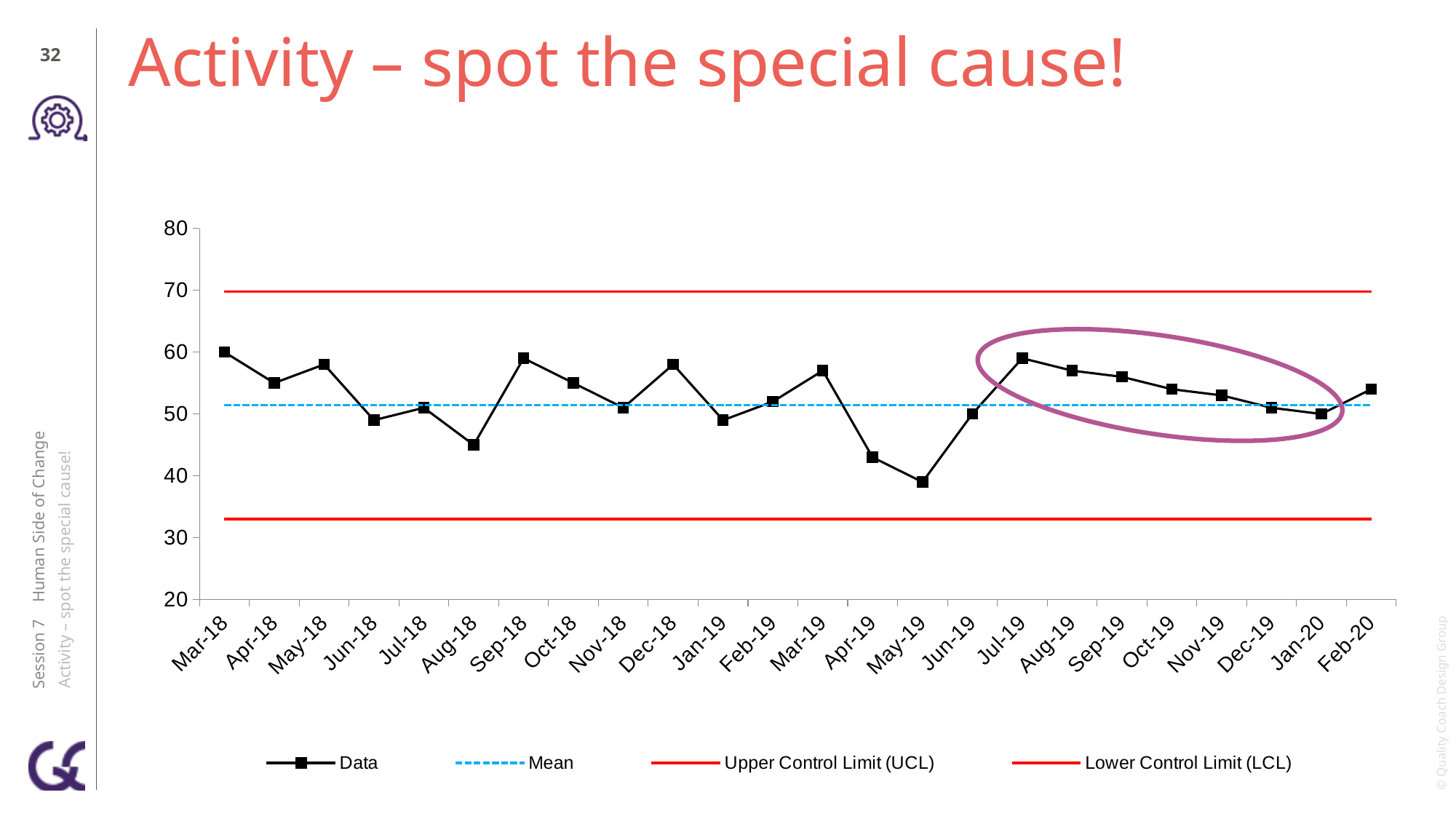
Is the Data value for Mar-19 greater or less than 50? greater Which has the larger Data value, Mar-18 or May-19? Mar-18 How many series does the legend list? 4 Is the Data value for Sep-18 greater or less than 50? greater Is the Data value for Aug-18 greater or less than 50? less How many monthly data points are plotted along the x axis? 24 What kind of chart is shown on the slide? Line chart What colour are the Upper Control Limit (UCL) and Lower Control Limit (LCL) lines? Red Which month has the lowest Data value? May-19 Between Jul-19 and Jan-20, do the Data values rise or fall? fall What is the title of the slide containing the chart? Activity – spot the special cause!